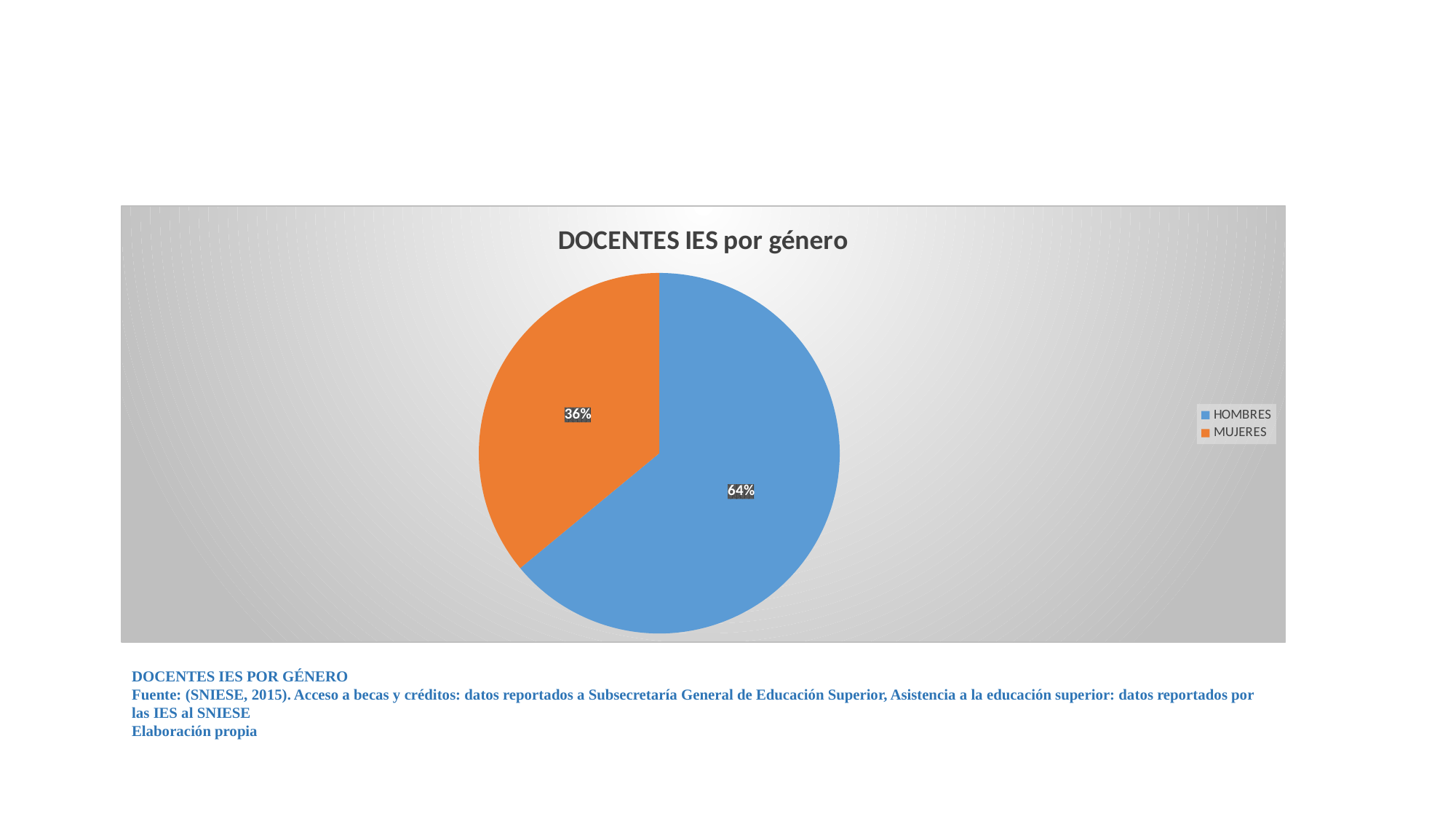
How many entries does the legend list? 2 What colour is the MUJERES slice? orange What percentage of the pie is MUJERES? 36% Which category has the smallest share of the pie? MUJERES Which is larger, the share for HOMBRES or the share for MUJERES? HOMBRES What share of the pie does the HOMBRES slice represent? 64% What percentage of the pie is HOMBRES? 64% What is the difference in percentage points between HOMBRES and MUJERES? 28 What is the title of the chart? DOCENTES IES por género How many slices does the pie chart have? 2 What type of chart is shown on the slide? pie chart Which category has the largest share of the pie? HOMBRES